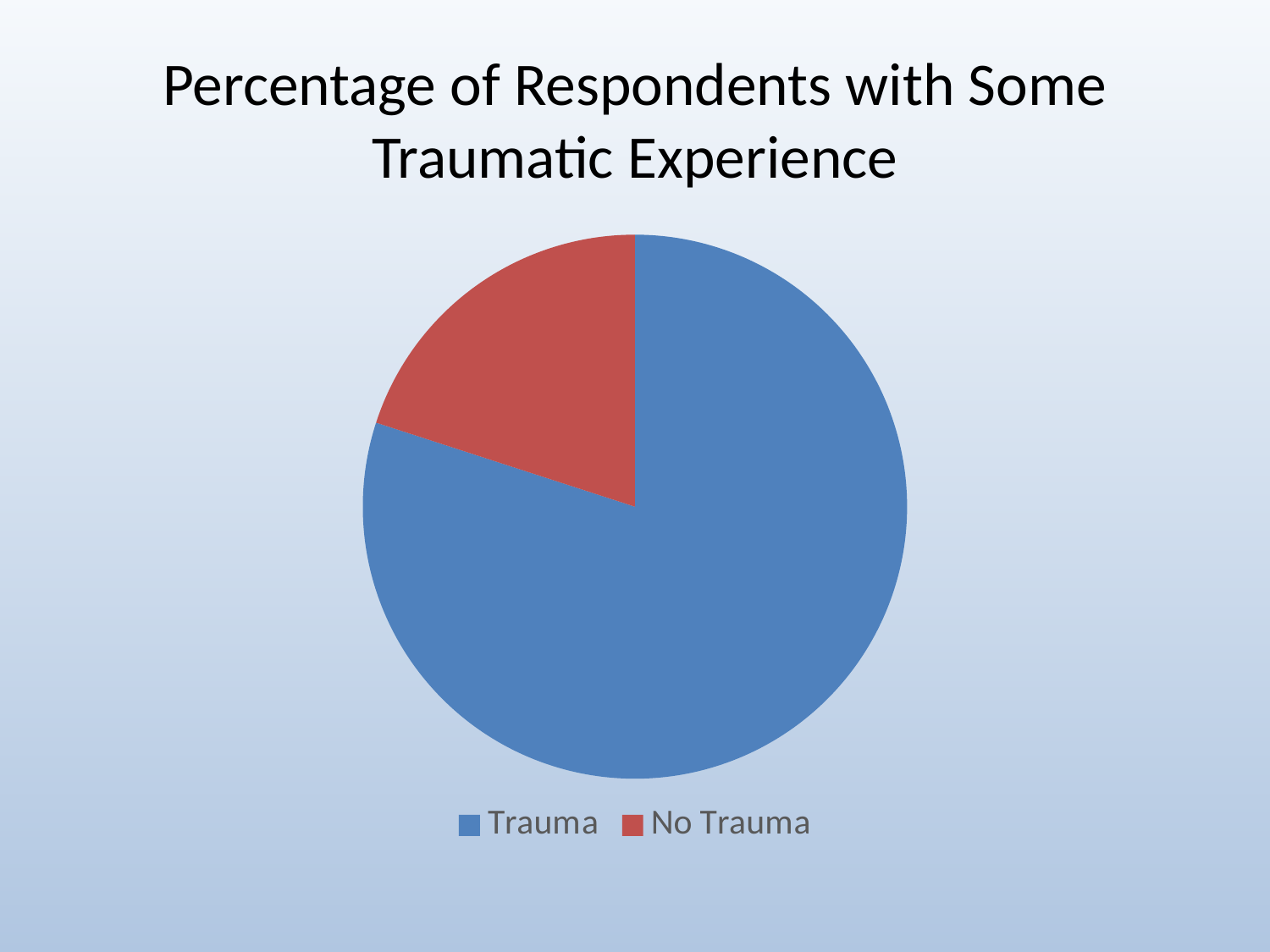
Which slice is the largest? Trauma What is the title of the chart? Percentage of Respondents with Some Traumatic Experience What colour is the Trauma slice? blue What kind of chart is shown on the slide? pie chart Does the Trauma slice take up more or less than half of the pie? more How many entries does the legend list? 2 Which is larger, the Trauma slice or the No Trauma slice? Trauma How many slices does the pie chart have? 2 Which slice is the smallest? No Trauma